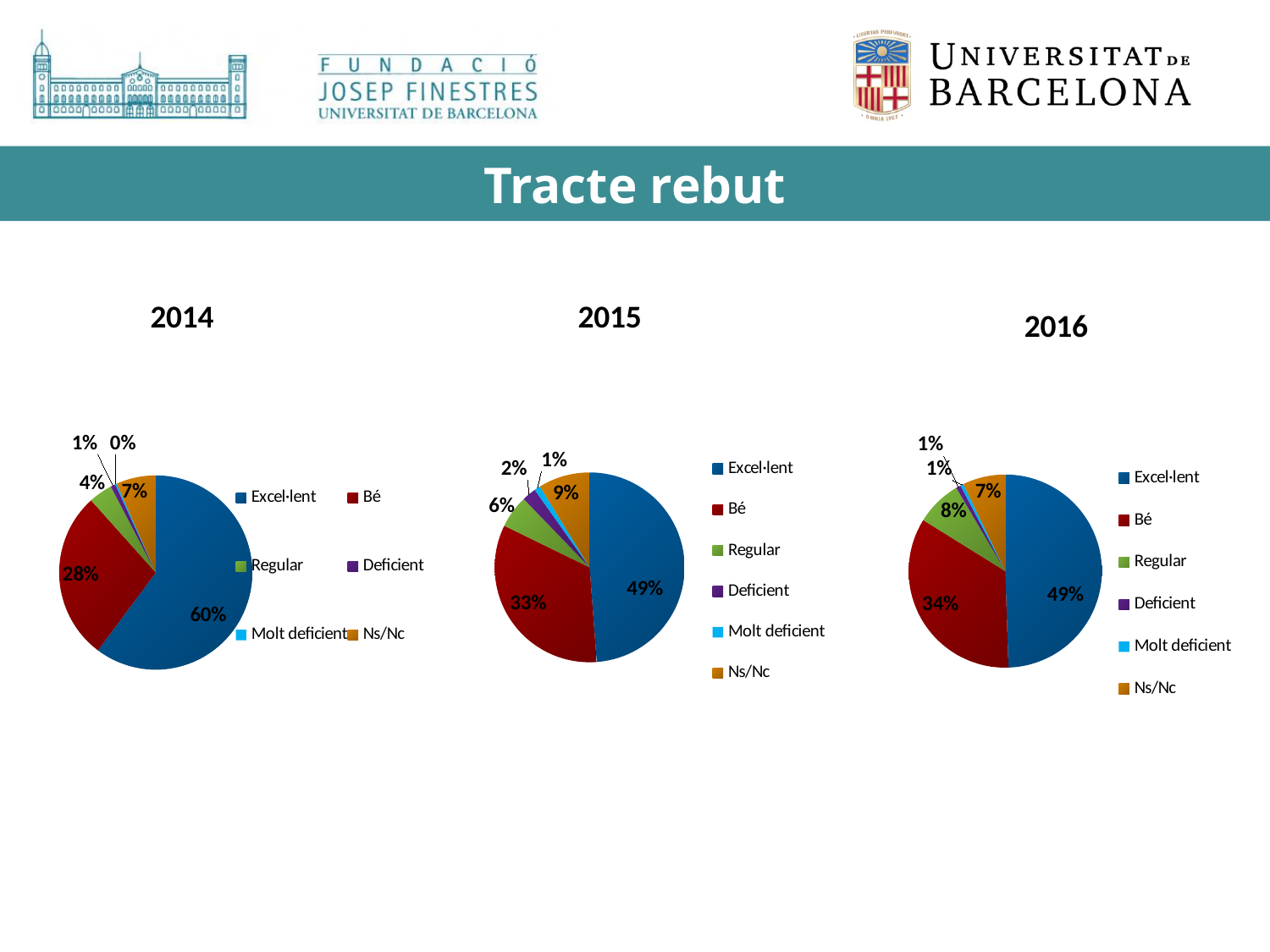
What type of chart is used for the 2015 data? Pie chart In the 2016 pie chart, what share is labelled for Regular? 8% In the 2015 pie chart, what share is labelled for Ns/Nc? 9% How many categories does the legend of the 2016 pie chart list? 6 In the 2014 pie chart, which category has the largest slice? Excel·lent How many pie charts are shown on the slide? 3 In the 2015 pie chart, what share is labelled for Bé? 33% Which is larger in the 2015 pie chart: the Regular slice or the Ns/Nc slice? Ns/Nc In the 2016 pie chart, what is the difference between the Excel·lent share and the Bé share? 15% In the 2014 pie chart, what share is labelled for Excel·lent? 60% What is the title of the slide containing the three pie charts? Tracte rebut In the 2014 pie chart, which category has the smallest slice? Molt deficient